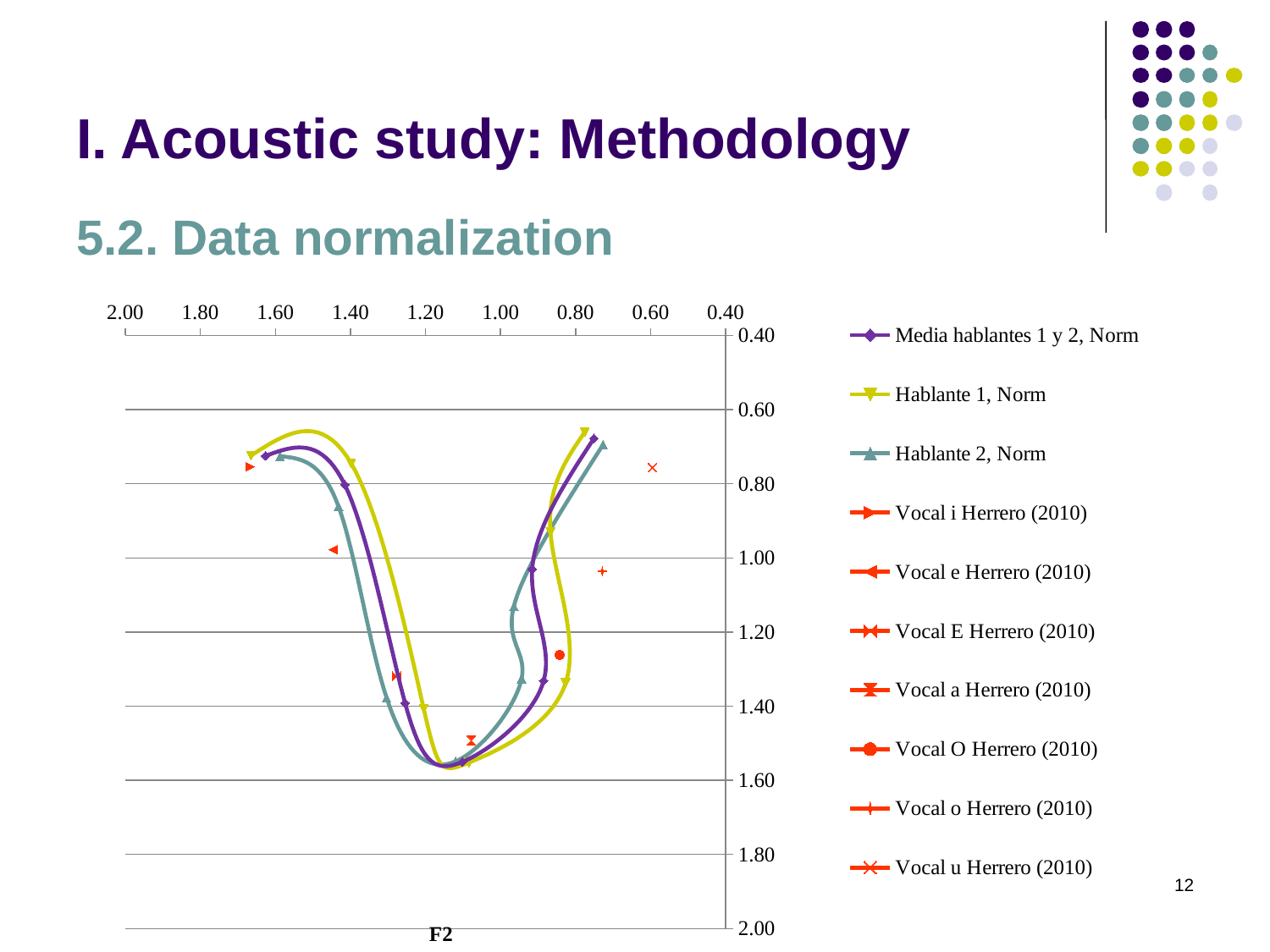
Which point has the larger F2 value, Vocal i Herrero (2010) or Vocal u Herrero (2010)? Vocal i Herrero (2010) Is the vertical-axis value of the Vocal O Herrero (2010) point greater or less than 1.40? less Is the F2 value of the Vocal i Herrero (2010) point greater or less than 1.40? greater How many series does the legend list? 10 Is the vertical-axis value of the Vocal u Herrero (2010) point greater or less than 1.00? less What is the first series listed in the legend? Media hablantes 1 y 2, Norm What is the title of the horizontal axis? F2 Among the Herrero (2010) vowel points, which has the highest vertical-axis value? Vocal a Herrero (2010) Which point has the larger vertical-axis value, Vocal a Herrero (2010) or Vocal u Herrero (2010)? Vocal a Herrero (2010) What kind of chart is shown on the slide? line chart (scatter with smoothed lines)